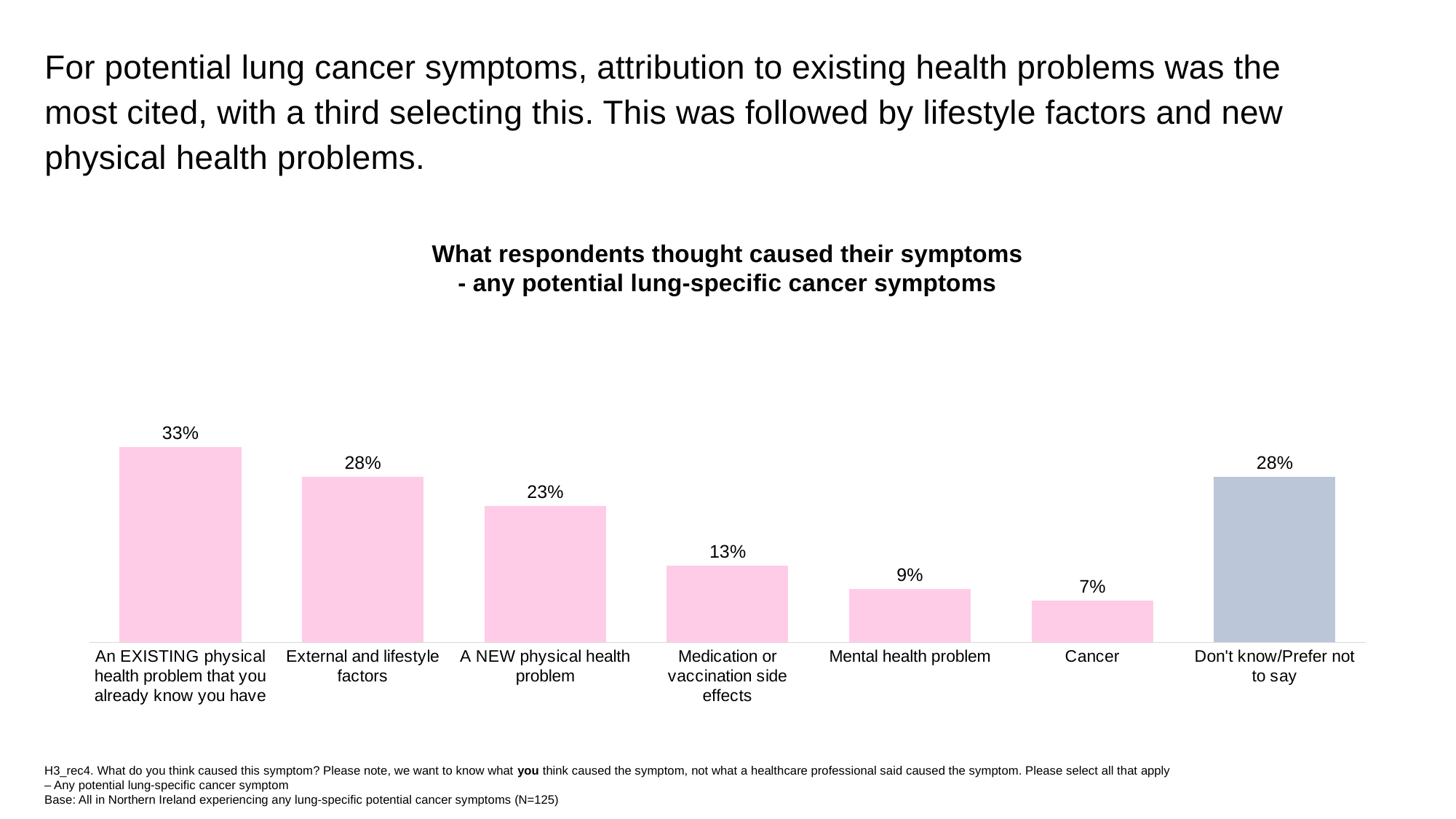
What percentage selected 'Medication or vaccination side effects'? 13% What percentage of respondents attributed their symptoms to an existing physical health problem that they already know they have? 33% Which bar is shown in a different colour (grey-blue) from the others? Don't know/Prefer not to say Which is larger: 'A NEW physical health problem' or 'Medication or vaccination side effects'? A NEW physical health problem Which category has the lowest value? Cancer What type of chart is shown on the slide? Bar chart What is the difference between 'Mental health problem' and 'Cancer'? 2 percentage points What is the value for 'Cancer'? 7% What is the value for 'Don't know/Prefer not to say'? 28% How many categories are shown in the chart? 7 Which category has the highest value? An EXISTING physical health problem that you already know you have What is the difference between 'External and lifestyle factors' and 'A NEW physical health problem'? 5 percentage points